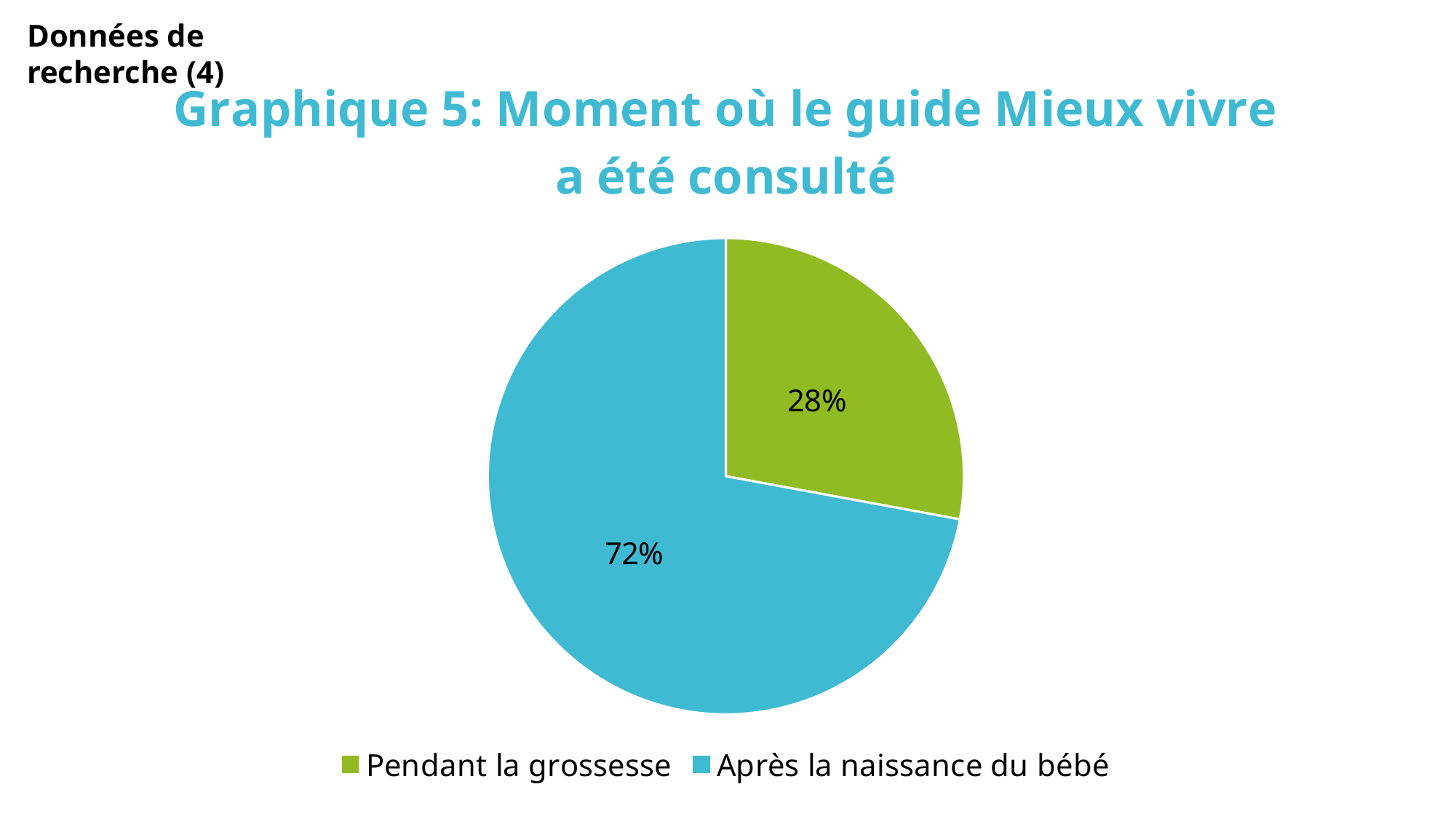
Which category has the smallest slice? Pendant la grossesse What is the title of the chart? Graphique 5: Moment où le guide Mieux vivre a été consulté How many entries does the legend list? 2 What share of the pie does "Pendant la grossesse" represent? 28% Which category has the largest slice? Après la naissance du bébé How many slices does the pie chart have? 2 What colour is the slice for "Pendant la grossesse"? green What kind of chart is shown on the slide? pie chart What is the value for "Après la naissance du bébé"? 72% What is the difference between the values for "Après la naissance du bébé" and "Pendant la grossesse"? 44% Which is larger: "Pendant la grossesse" or "Après la naissance du bébé"? Après la naissance du bébé What is the value for "Pendant la grossesse"? 28%